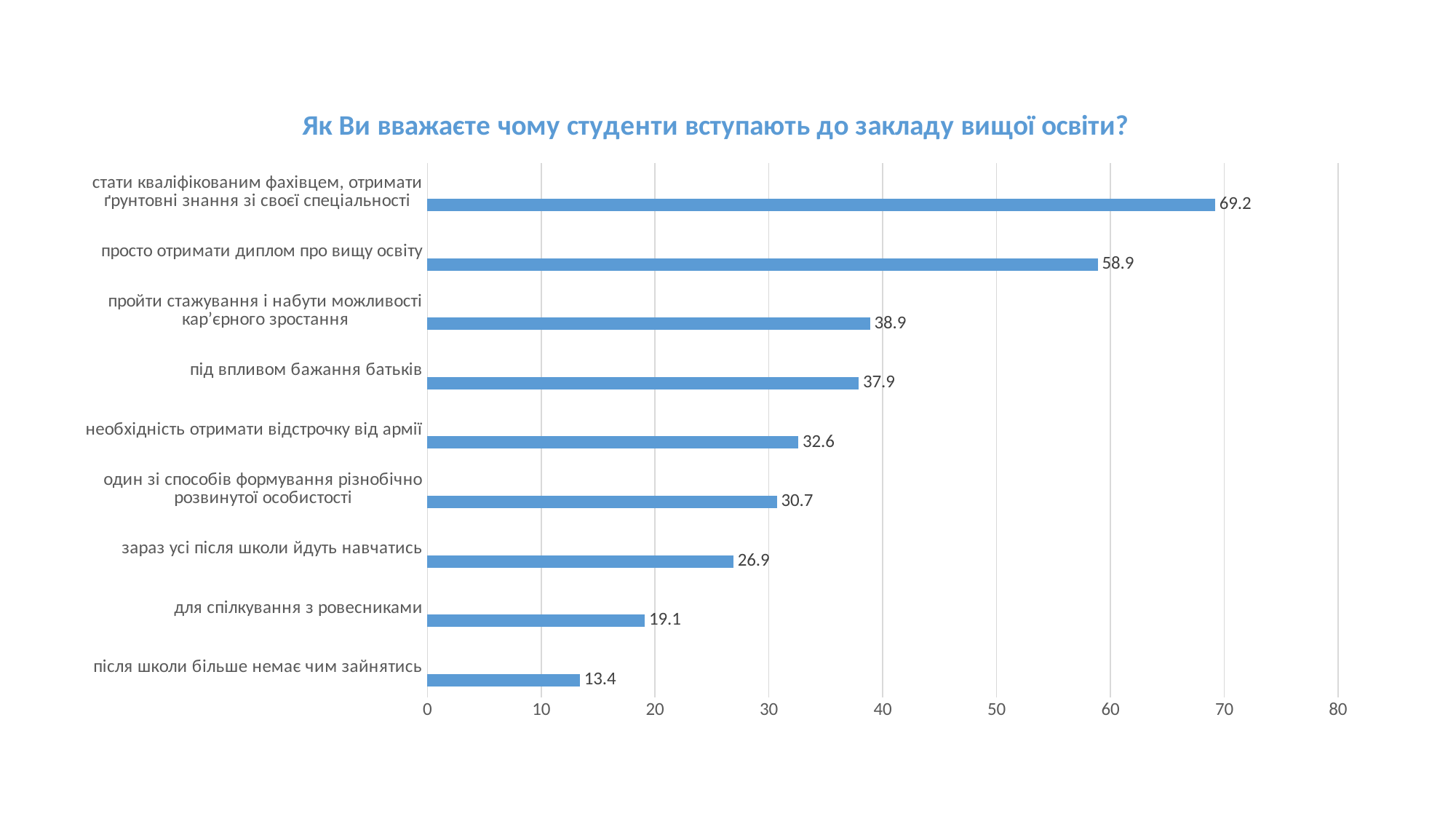
Which is larger: the value for "зараз усі після школи йдуть навчатись" or the value for "для спілкування з ровесниками"? зараз усі після школи йдуть навчатись What is the difference between the values for "стати кваліфікованим фахівцем, отримати ґрунтовні знання зі своєї спеціальності" and "просто отримати диплом про вищу освіту"? 10.3 What is the difference between the values for "необхідність отримати відстрочку від армії" and "після школи більше немає чим зайнятись"? 19.2 What kind of chart is shown on the slide? bar chart Which category has the highest value? стати кваліфікованим фахівцем, отримати ґрунтовні знання зі своєї спеціальності What value is shown for "під впливом бажання батьків"? 37.9 What is the title of the chart? Як Ви вважаєте чому студенти вступають до закладу вищої освіти? Which category has the lowest value? після школи більше немає чим зайнятись How many categories are shown in the chart? 9 Is the value for "один зі способів формування різнобічно розвинутої особистості" greater or less than 40? less What value is shown for "просто отримати диплом про вищу освіту"? 58.9 What value is shown for "для спілкування з ровесниками"? 19.1